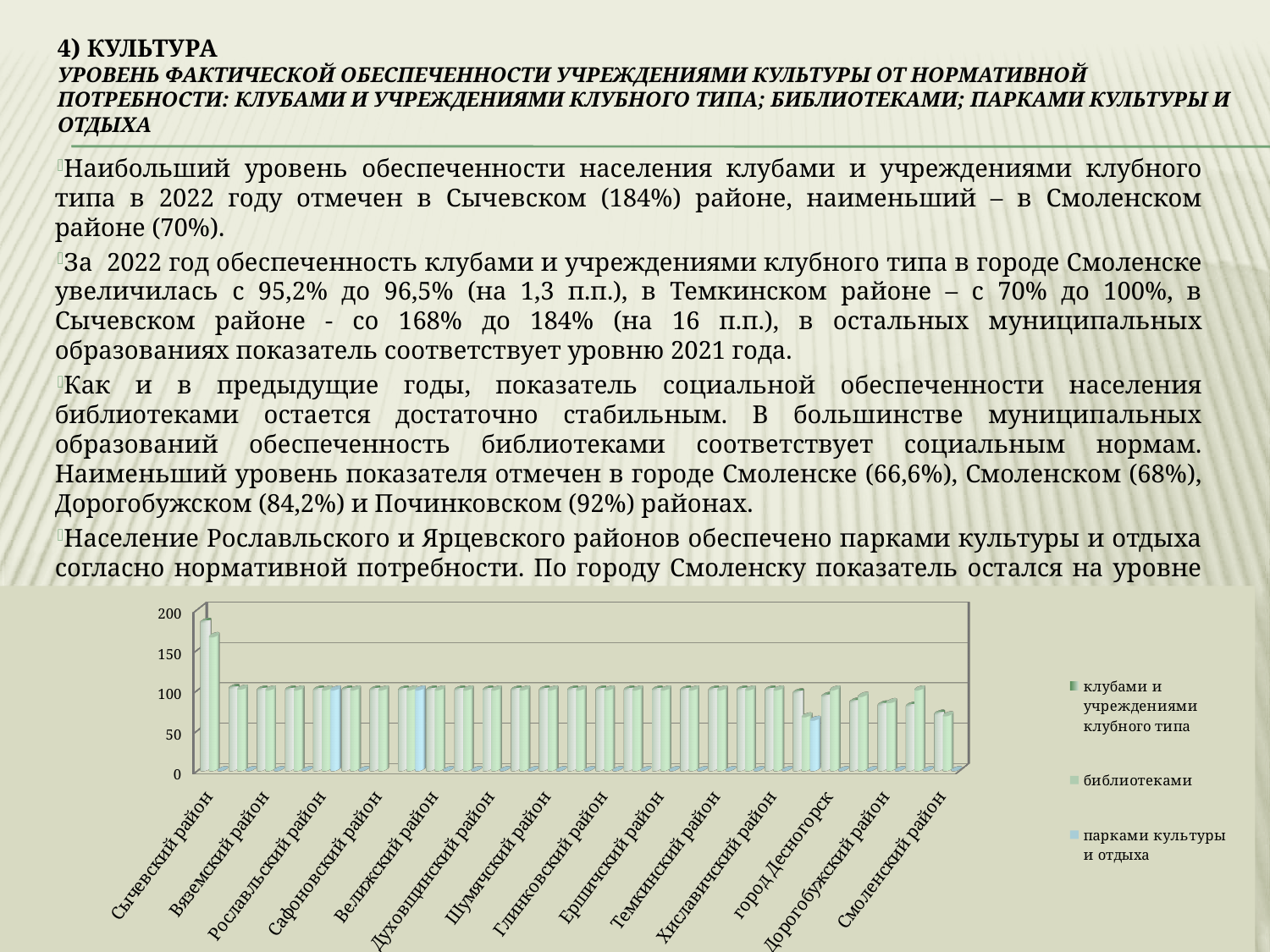
Which category has the highest value for клубами и учреждениями клубного типа? Сычевский район Is the value for клубами и учреждениями клубного типа in Смоленский район greater or less than 100? less Is the value for клубами и учреждениями клубного типа in Сычевский район greater or less than 150? greater How many series does the chart legend list? 3 Which series is listed first in the chart legend? клубами и учреждениями клубного типа Which has the larger value for клубами и учреждениями клубного типа: Сычевский район or Вяземский район? Сычевский район Is the value for парками культуры и отдыха in город Десногорск greater or less than 100? less What kind of chart is shown on the slide? bar chart Which series is listed last in the chart legend? парками культуры и отдыха Which category has the lowest value for клубами и учреждениями клубного типа? Смоленский район